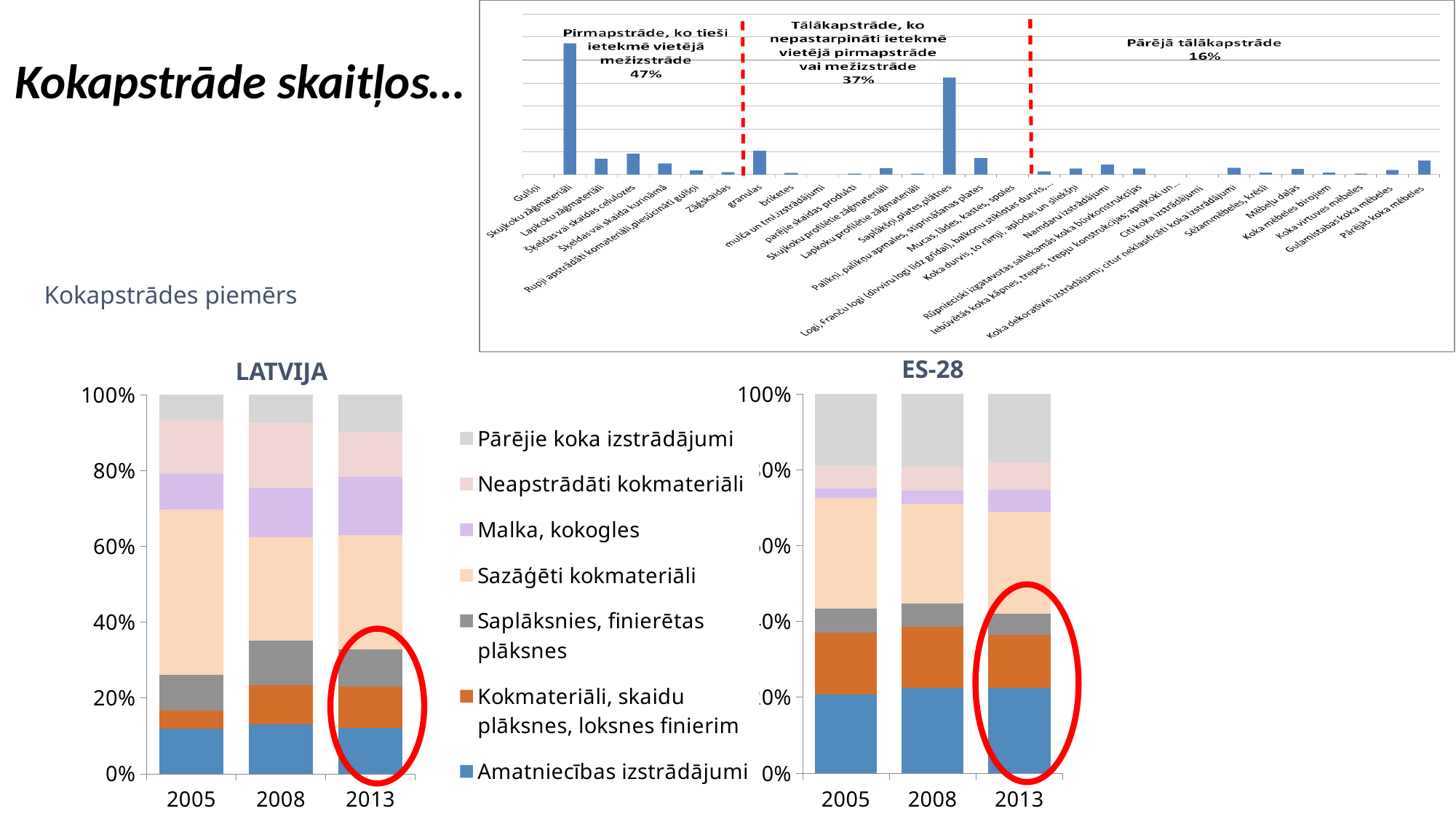
In the top-right chart (Kokapstrādes piemērs), what percentage is shown for the Pirmapstrāde group? 47% In the ES-28 chart, is the cumulative top of the Kokmateriāli, skaidu plāksnes, loksnes finierim segment for 2013 greater or less than 40%? less Which series is shown in blue at the bottom of the stacked bars in the LATVIJA and ES-28 charts? Amatniecības izstrādājumi In the LATVIJA chart, is the top of the Amatniecības izstrādājumi segment for 2005 greater or less than 20%? less In the top-right chart (Kokapstrādes piemērs), what percentage is shown for Pārējā tālākapstrāde? 16% What kind of chart is the LATVIJA chart? stacked bar chart How many years are shown on the x axis of the ES-28 chart? 3 In the LATVIJA chart, what is the total of the stacked bar for 2013? 100% In the top-right chart (Kokapstrādes piemērs), which bar is taller: Skujkoku zāģmateriāli or Saplāksnis, plates, plātnes? Skujkoku zāģmateriāli How many series does the legend shared by the LATVIJA and ES-28 charts list? 7 In the top-right chart (Kokapstrādes piemērs), which category has the highest bar? Skujkoku zāģmateriāli In the LATVIJA chart, is the cumulative top of the Sazāģēti kokmateriāli segment for 2005 greater or less than 60%? greater